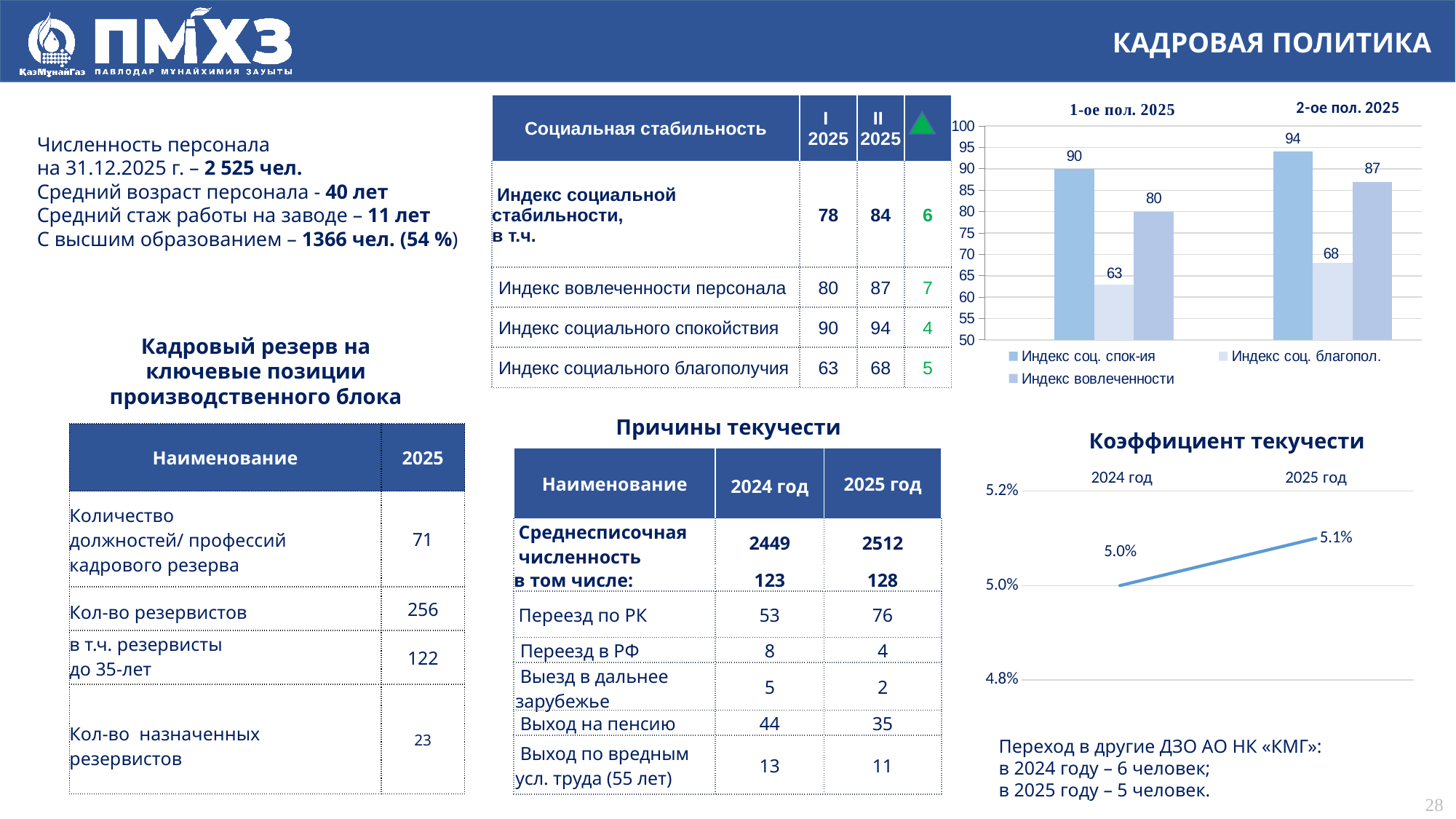
What type of chart is the Коэффициент текучести chart? Line chart In the bar chart at the top right, which series has the lowest value in 1-ое пол. 2025? Индекс соц. благопол. In the bar chart at the top right, is Индекс соц. спок-ия larger in 1-ое пол. 2025 or 2-ое пол. 2025? 2-ое пол. 2025 In the bar chart at the top right, what is the difference between Индекс вовлеченности in 2-ое пол. 2025 and 1-ое пол. 2025? 7 In the Коэффициент текучести chart, what is the value for 2025 год? 5.1% In the bar chart at the top right, what is the value of Индекс соц. спок-ия for 1-ое пол. 2025? 90 In the bar chart at the top right, what is the value of Индекс соц. благопол. for 2-ое пол. 2025? 68 What type of chart is the chart at the top right of the slide? Bar chart How many series does the legend of the bar chart at the top right list? 3 In the bar chart at the top right, which series has the highest value in 2-ое пол. 2025? Индекс соц. спок-ия In the bar chart at the top right, what is the value of Индекс вовлеченности for 2-ое пол. 2025? 87 In the Коэффициент текучести chart, does the value rise or fall from 2024 год to 2025 год? Rise